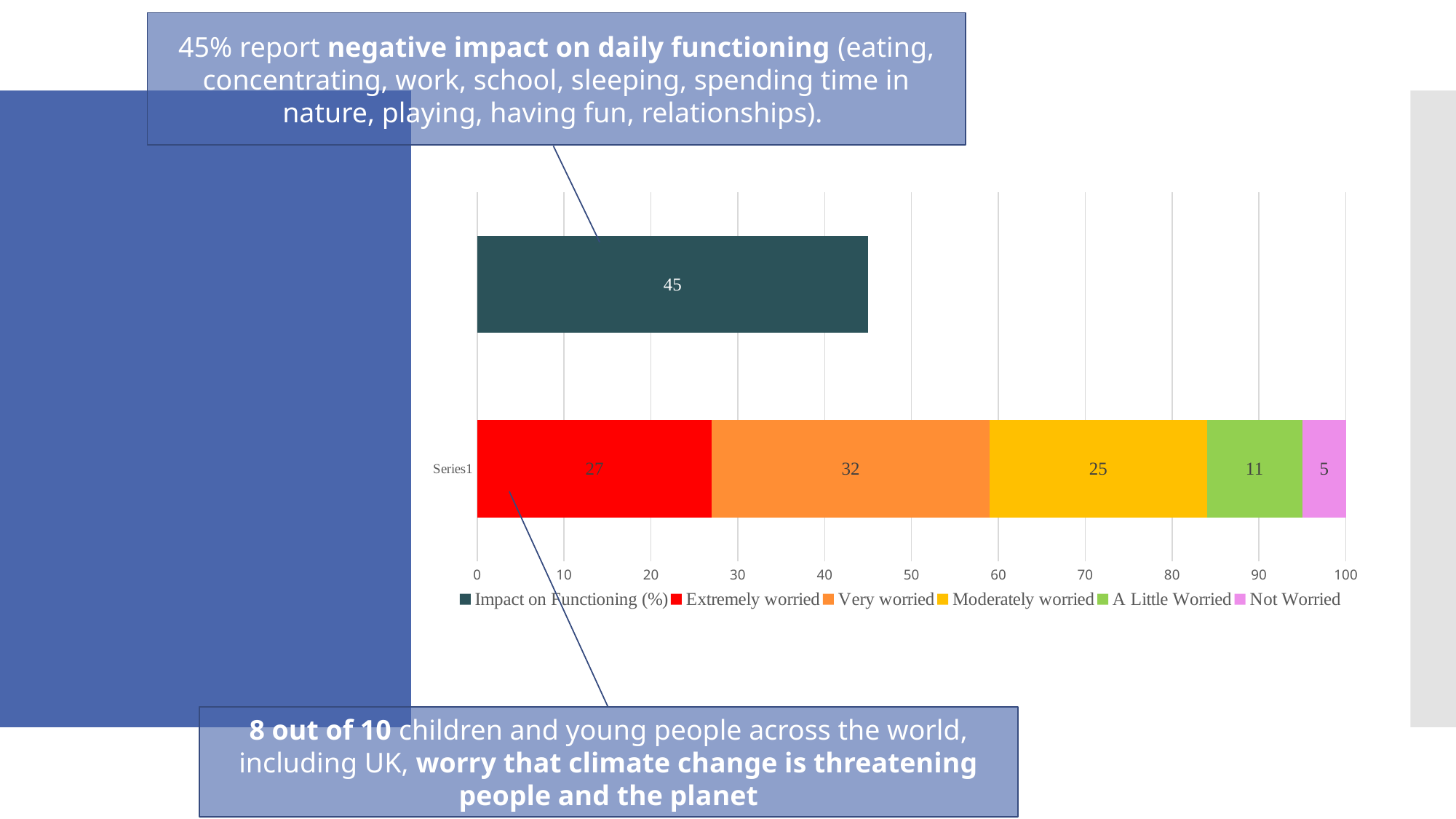
What is the value for Extremely worried in the Series1 bar? 27 What is the value for Impact on Functioning (%)? 45 Which segment of the Series1 stacked bar is the largest? Very worried What is the difference between the Very worried and Moderately worried values? 7 What is the value for Very worried in the Series1 bar? 32 What kind of chart is shown on the slide? bar chart What colour is the Moderately worried segment? yellow What is the total of the Series1 stacked bar? 100 Which is larger, Extremely worried or A Little Worried? Extremely worried What is the value for Not Worried in the Series1 bar? 5 How many series does the legend list? 6 Which segment of the Series1 stacked bar is the smallest? Not Worried